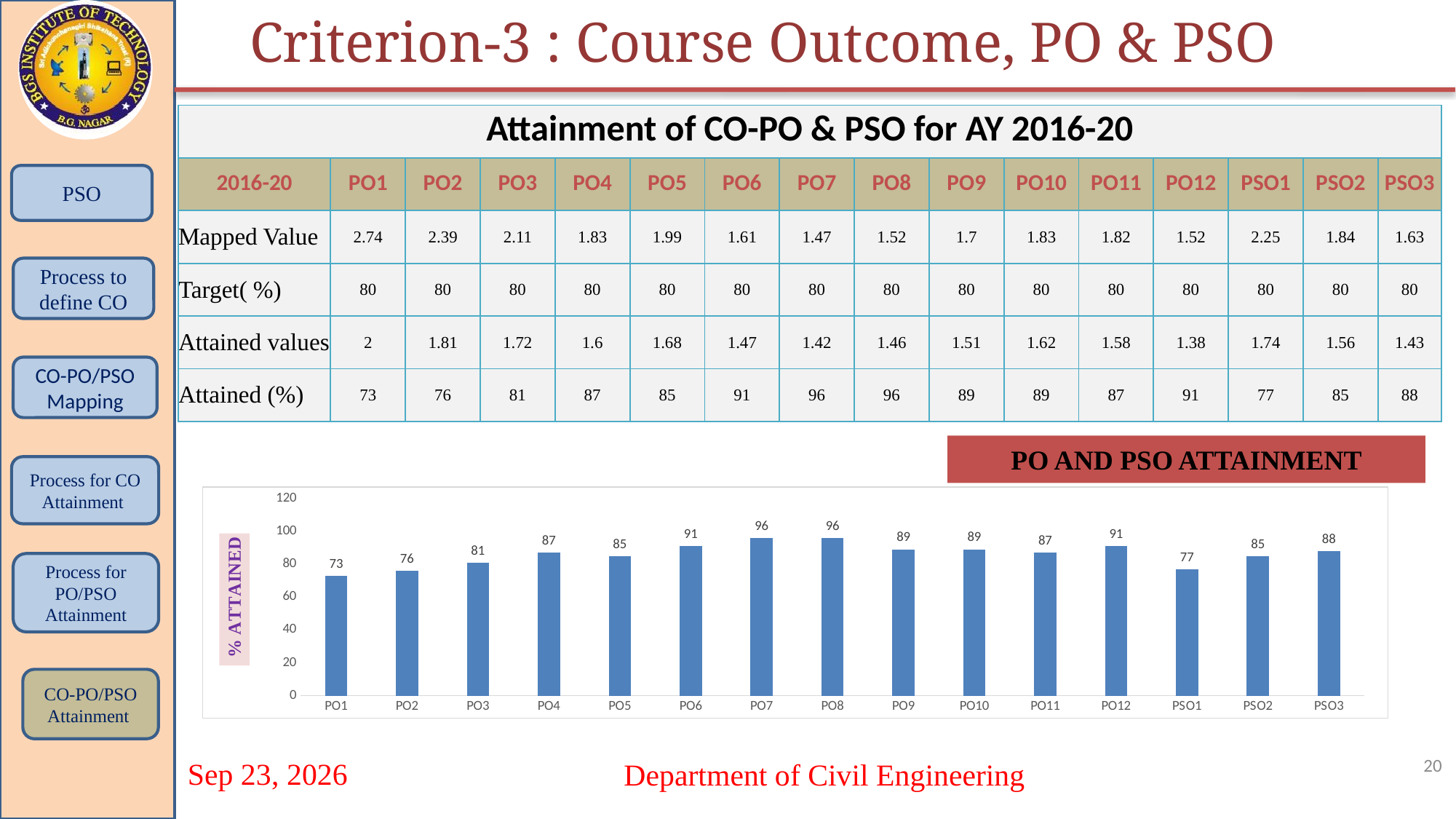
What is the % attained value for PO4 in the chart? 87 Which category has the lowest % attained in the chart? PO1 What is the label on the vertical axis of the chart? % ATTAINED What is the highest % attained value shown in the chart? 96 What is the difference between the % attained for PO7 and PO1? 23 What kind of chart is shown on the slide? bar chart What is the % attained value for PSO1 in the chart? 77 What is the % attained value for PO1 in the chart? 73 What is the title shown above the chart? PO AND PSO ATTAINMENT How many categories are plotted on the x axis of the chart? 15 Is the value for PO6 greater or less than 80? greater Which has a higher % attained, PO3 or PSO3? PSO3